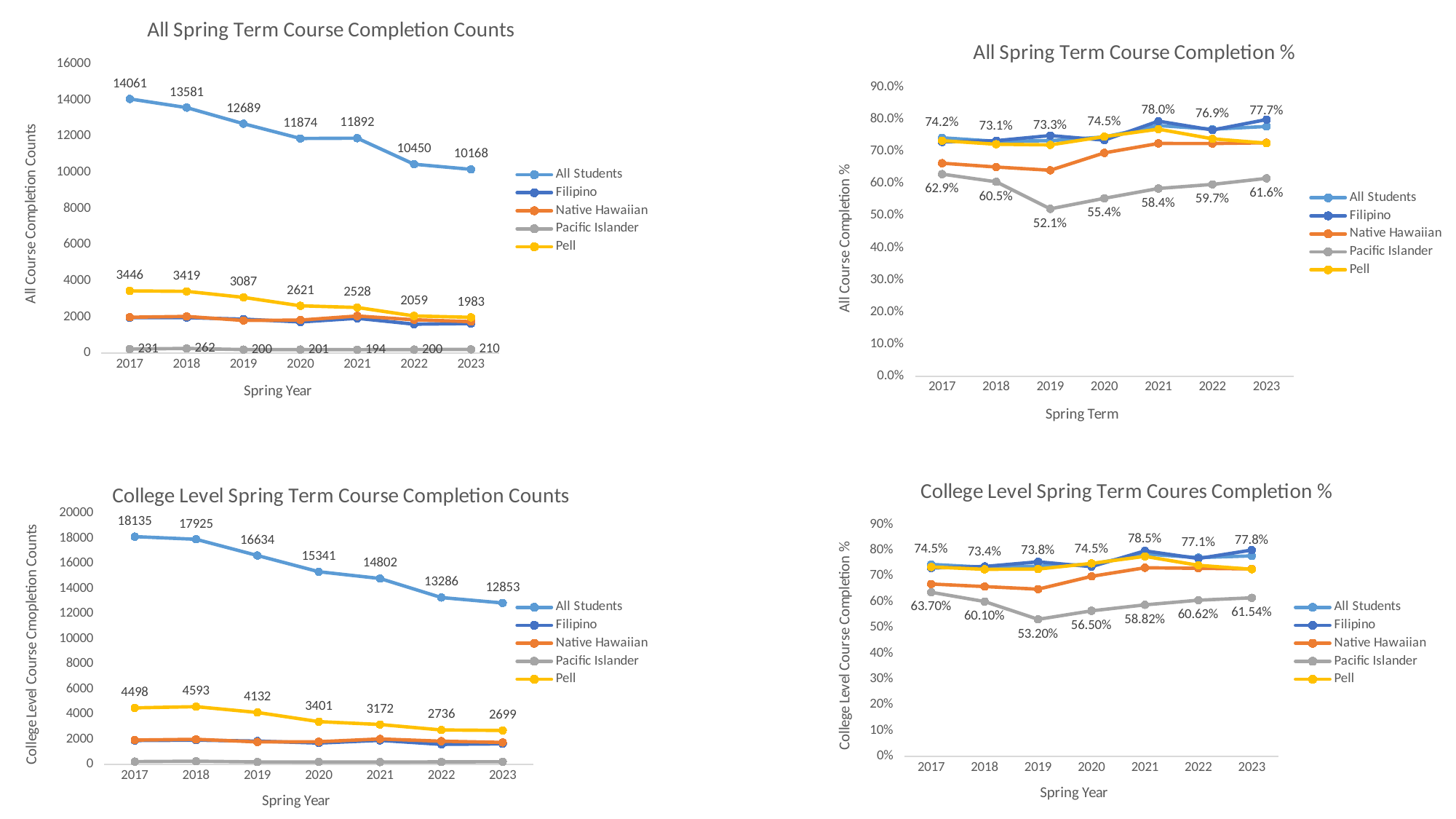
In the 'College Level Spring Term Course Completion Counts' chart, what is the All Students value in 2020? 15341 In the 'College Level Spring Term Course Completion Counts' chart, does the All Students line rise or fall from 2017 to 2023? fall In the 'All Spring Term Course Completion Counts' chart, by how much did the All Students count fall from 2017 to 2023? 3893 In the 'All Spring Term Course Completion %' chart, is the Native Hawaiian value for 2019 greater or less than 70.0%? less In the 'All Spring Term Course Completion %' chart, in which year is the Pacific Islander value highest? 2017 In the 'All Spring Term Course Completion Counts' chart, what is the value for All Students in 2017? 14061 In the 'All Spring Term Course Completion %' chart, in which year is the Pacific Islander value lowest? 2019 In the 'All Spring Term Course Completion Counts' chart, which is larger for Pell: 2018 or 2019? 2018 How many series does the legend of the 'All Spring Term Course Completion Counts' chart list? 5 In the 'All Spring Term Course Completion Counts' chart, what is the Pell value in 2023? 1983 In the 'College Level Spring Term Coures Completion %' chart, what is the Pacific Islander value in 2019? 53.20% What kind of chart is the 'All Spring Term Course Completion %' chart? line chart